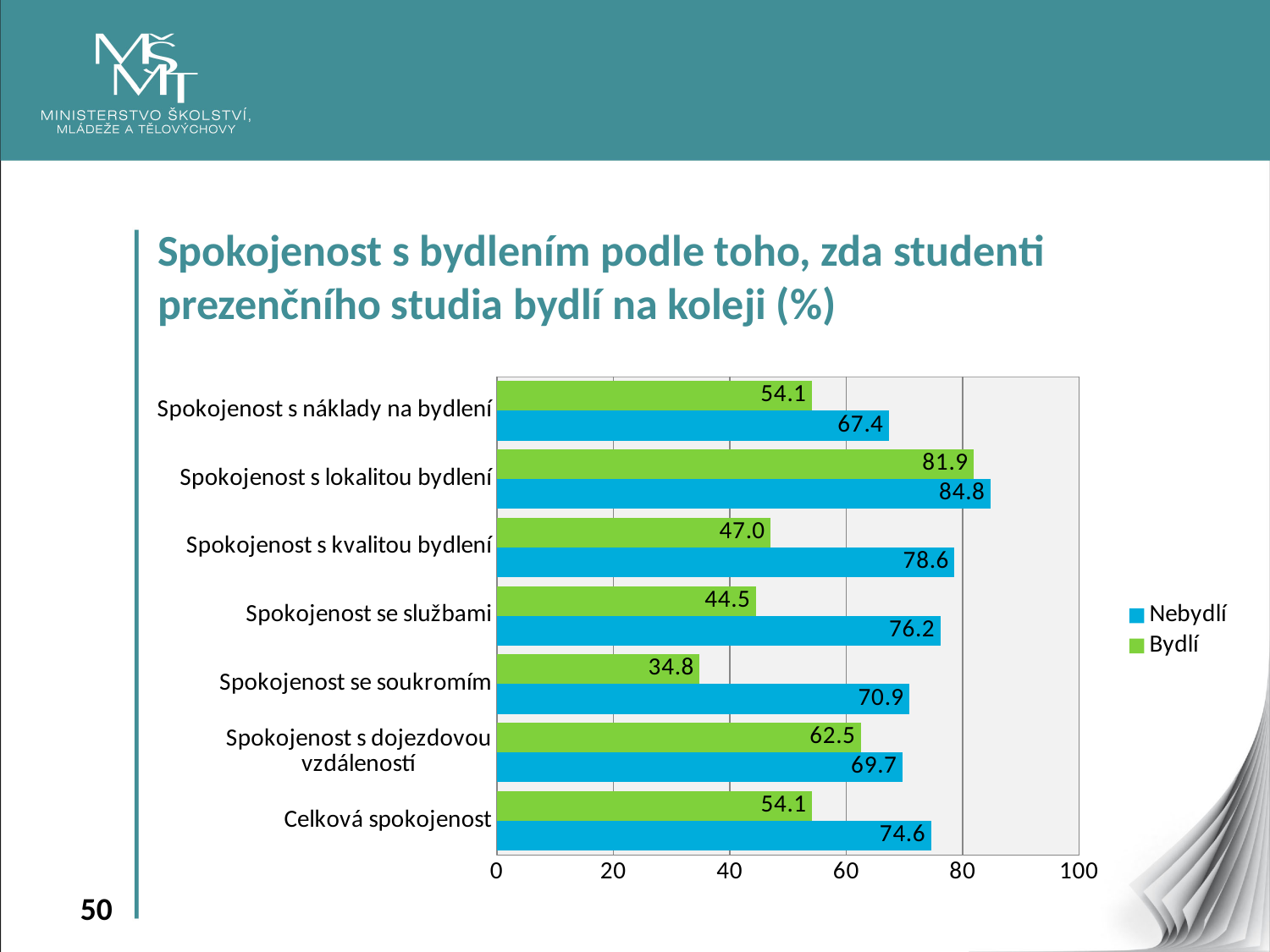
What is the difference between the Nebydlí and Bydlí values for Spokojenost s dojezdovou vzdáleností? 7.2 What is the value for Bydlí in the category Spokojenost se soukromím? 34.8 Which category has the lowest value for the Nebydlí series? Spokojenost s náklady na bydlení How many series does the legend list? 2 What is the value for Nebydlí in the category Celková spokojenost? 74.6 How many categories are shown on the chart? 7 Which is larger for Spokojenost s kvalitou bydlení: the Nebydlí value or the Bydlí value? Nebydlí What is the value for Nebydlí in the category Spokojenost s lokalitou bydlení? 84.8 Which category has the highest value for the Bydlí series? Spokojenost s lokalitou bydlení What kind of chart is shown on the slide? Bar chart Which colour represents the Bydlí series in the chart? Green What is the difference between the Nebydlí and Bydlí values for Spokojenost se soukromím? 36.1